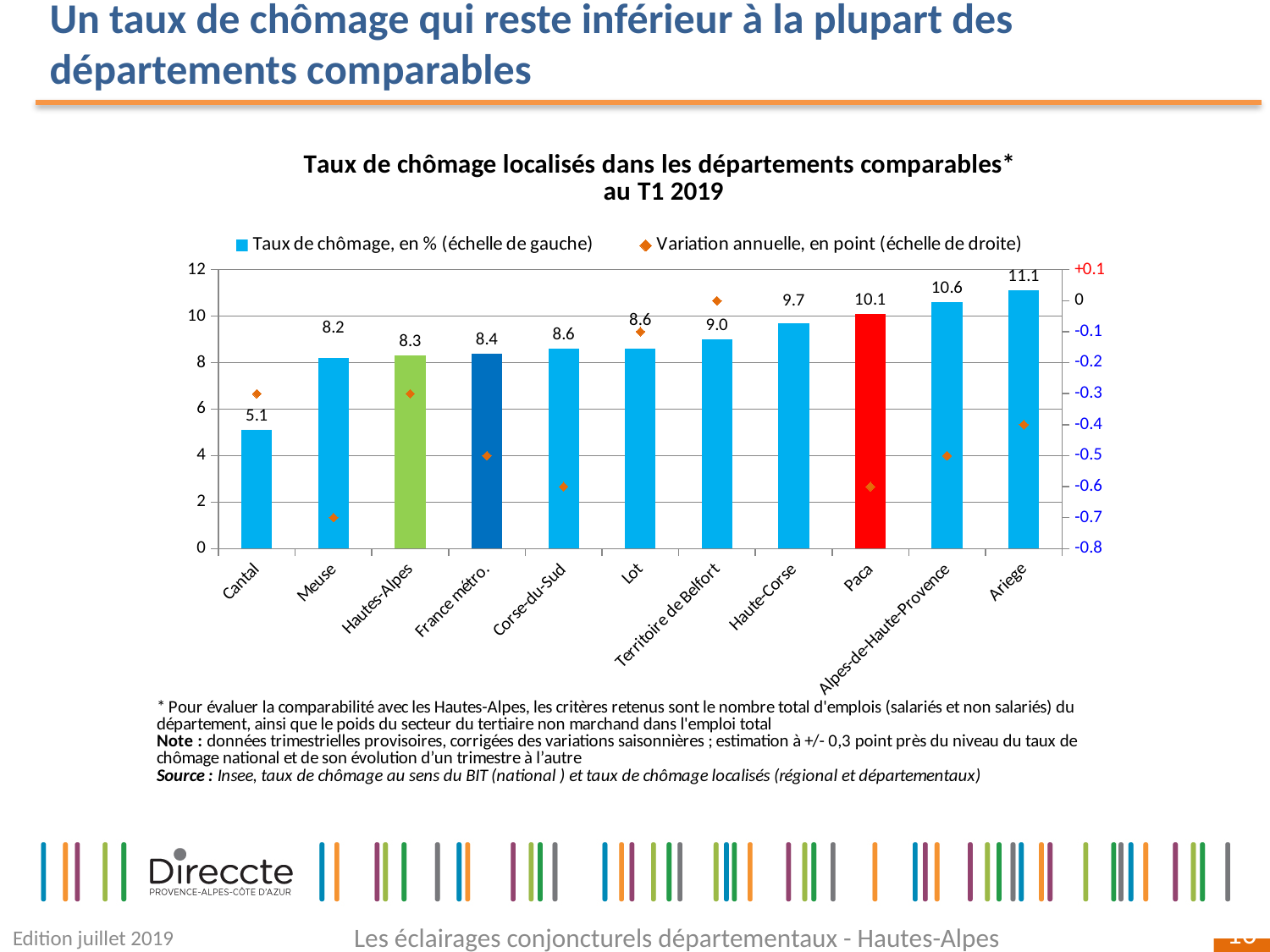
Which category has the highest unemployment rate bar? Ariege How many categories are shown on the x axis? 11 What is the unemployment rate (Taux de chômage) shown for Hautes-Alpes? 8.3 How many series does the legend list? 2 Is the annual variation (Variation annuelle) for Meuse greater or less than -0.5? less Which has a higher unemployment rate, Haute-Corse or Territoire de Belfort? Haute-Corse Which category's bar is coloured red? Paca What is the unemployment rate shown for Alpes-de-Haute-Provence? 10.6 Is the annual variation (Variation annuelle) for Lot greater or less than -0.3? greater What kind of chart is used to show the unemployment rate? Bar chart Which category has the lowest unemployment rate bar? Cantal What is the difference between the unemployment rate of Paca and that of Hautes-Alpes? 1.8